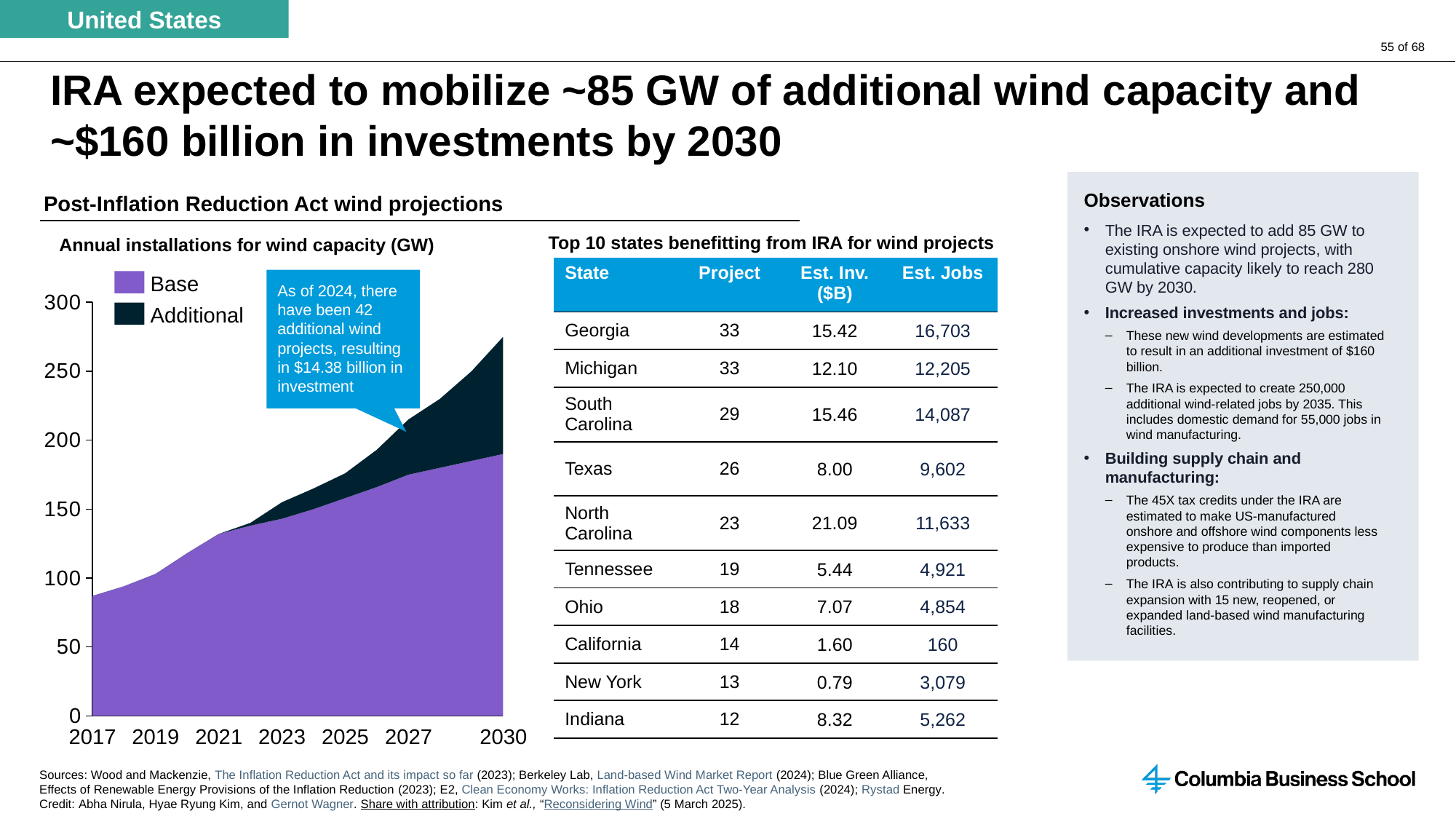
Is the combined Base plus Additional value for 2030 in the wind capacity chart greater or less than 250? greater Is the Base value for 2030 in the wind capacity chart greater or less than 200? less What are the two series named in the legend of the wind capacity chart? Base and Additional What kind of chart is the 'Annual installations for wind capacity (GW)' chart? Stacked area chart Is the Base value for 2021 in the wind capacity chart greater or less than 100? greater According to the callout on the wind capacity chart, how much investment had the 42 additional wind projects resulted in as of 2024? $14.38 billion How many series does the legend of the wind capacity chart list? 2 Do the values in the wind capacity chart rise or fall from 2017 to 2030? Rise How many year labels are shown on the x axis of the wind capacity chart? 7